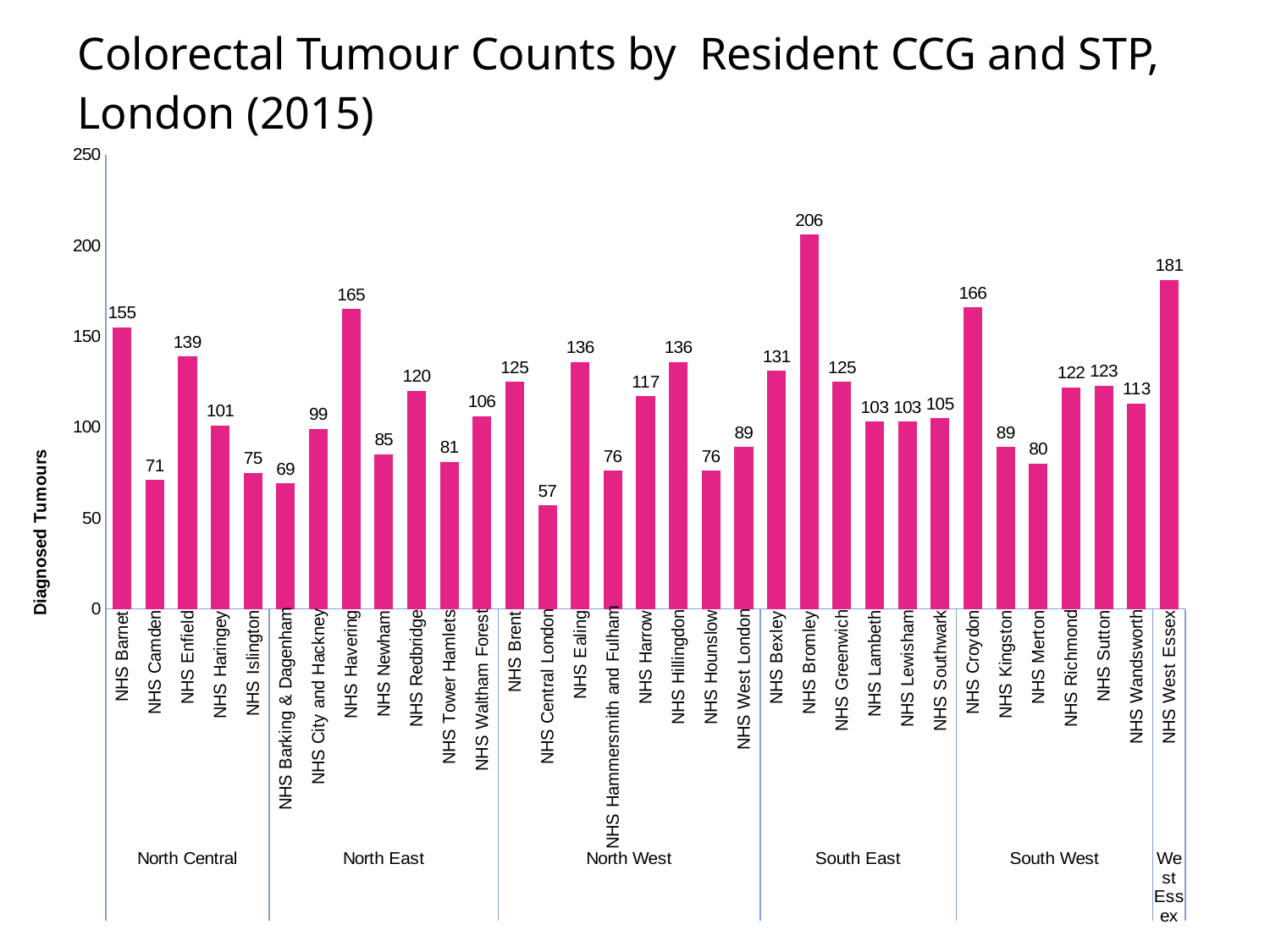
What is the difference between the values for NHS Barnet and NHS Camden? 84 How many CCG bars are plotted on the chart? 33 What is the label of the vertical axis? Diagnosed Tumours Which has a higher value, NHS Redbridge or NHS Harrow? NHS Redbridge What is the value for NHS Havering? 165 What type of chart is shown on the slide? Bar chart Which CCG has the highest number of diagnosed tumours? NHS Bromley What is the value for NHS Central London? 57 What is the difference between the values for NHS Bromley and NHS West Essex? 25 How many diagnosed tumours are shown for NHS Bromley? 206 Which CCG has the lowest number of diagnosed tumours? NHS Central London Which has a higher value, NHS Croydon or NHS Enfield? NHS Croydon